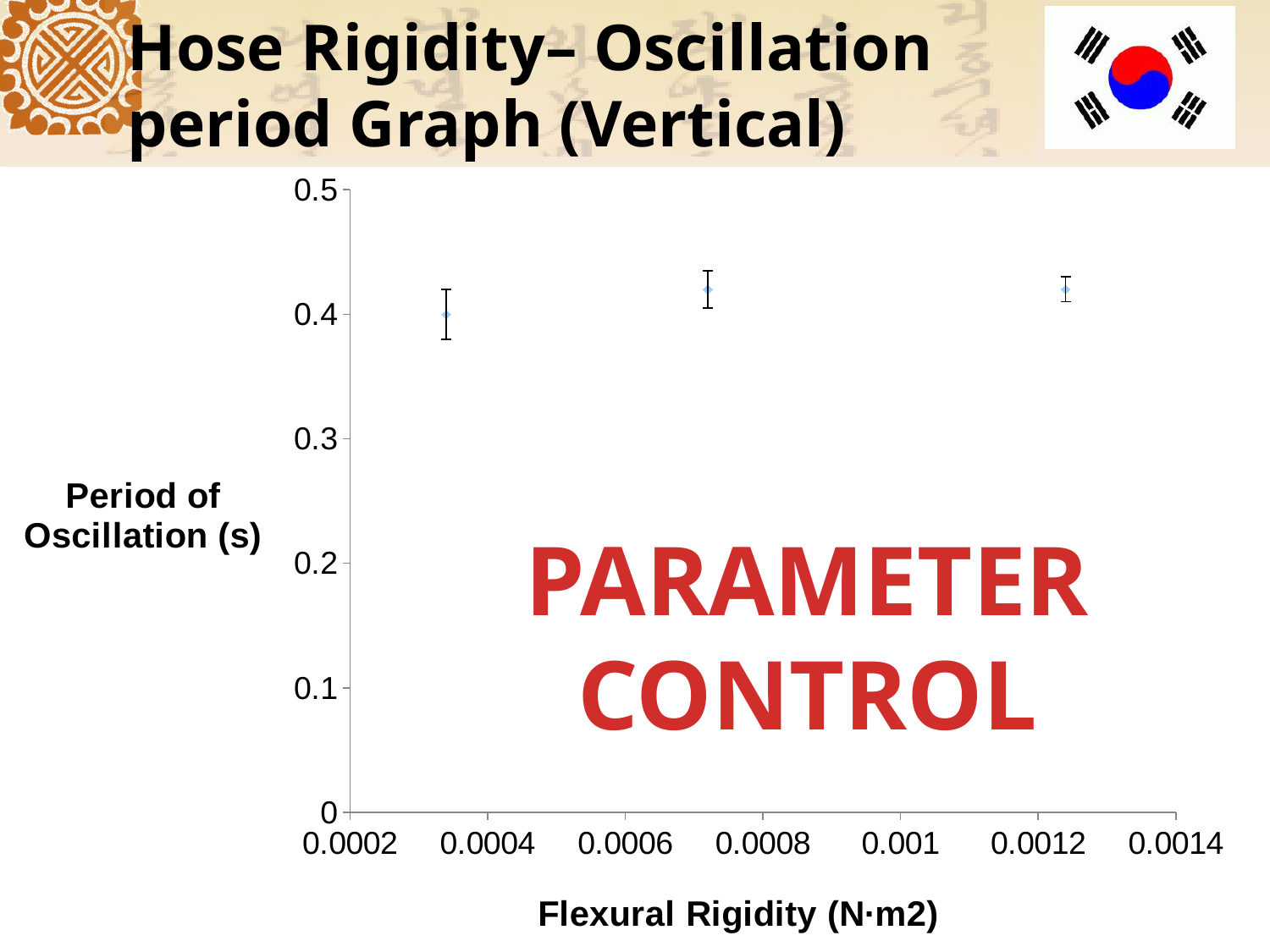
What kind of chart is shown on the slide? scatter chart What is the label of the y axis? Period of Oscillation (s) Which data point has the lowest period of oscillation? the point at the lowest flexural rigidity Which has the larger period of oscillation: the point at the lowest flexural rigidity or the middle point? the middle point How many data points are plotted on the chart? 3 Is the period of oscillation for the point at the highest flexural rigidity greater or less than 0.3? greater Is the period of oscillation for the point at the highest flexural rigidity greater or less than 0.5? less Is the period of oscillation for the middle data point greater or less than 0.4? greater What is the label of the x axis? Flexural Rigidity (N·m2)